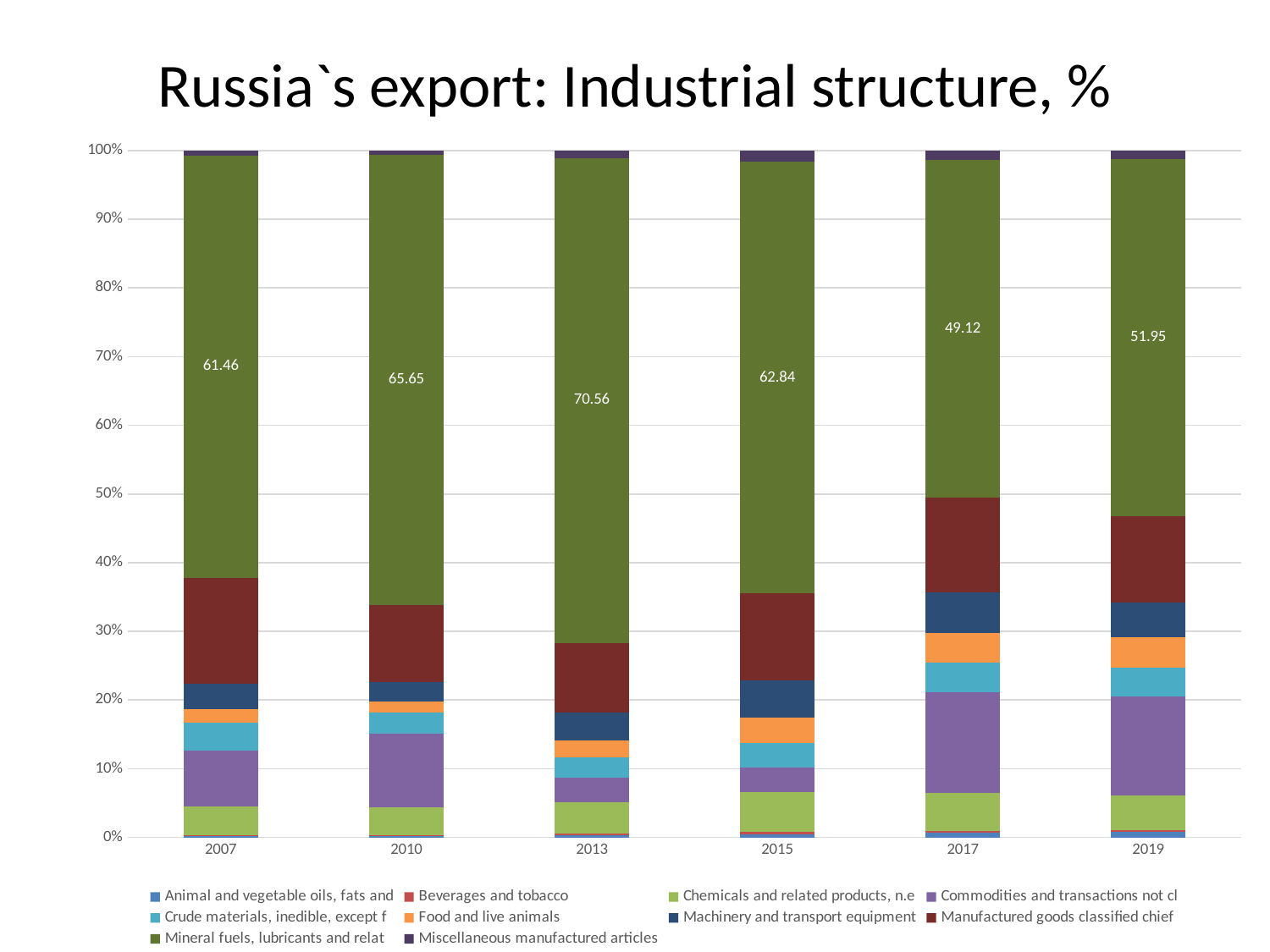
How many series does the legend list? 10 What is the value of Mineral fuels, lubricants and relat for 2007? 61.46 What is the value of Mineral fuels, lubricants and relat for 2017? 49.12 What is the difference between the Mineral fuels values for 2013 and 2017? 21.44 In which year is the Mineral fuels, lubricants and relat value the lowest? 2017 How many years are shown on the x axis? 6 In which year is the Mineral fuels, lubricants and relat value the highest? 2013 Does the Mineral fuels value rise or fall from 2013 to 2017? Fall What kind of chart is shown on the slide? Stacked bar chart What is the difference between the Mineral fuels values for 2010 and 2007? 4.19 What is the value of Mineral fuels, lubricants and relat for 2013? 70.56 Which year has the larger Mineral fuels value, 2015 or 2019? 2015